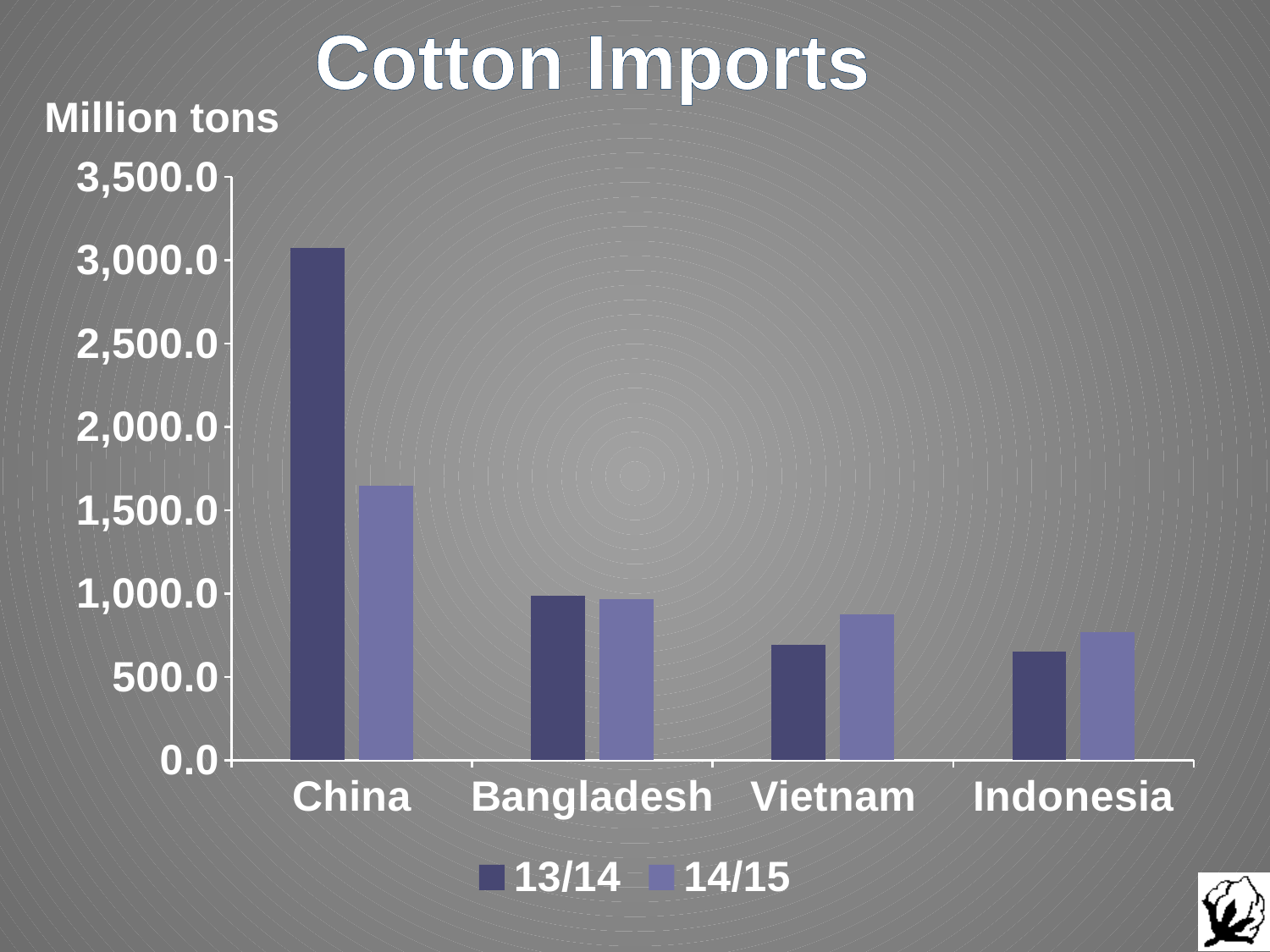
Is the 13/14 value for Indonesia greater or less than 500.0? greater Is the 14/15 value for Vietnam greater or less than 1,000.0? less For Vietnam, which series is larger, 13/14 or 14/15? 14/15 What type of chart is shown on the slide? bar chart For China, which series is larger, 13/14 or 14/15? 13/14 Which country has the highest 13/14 cotton imports? China What unit is given for the y axis of the chart? Million tons How many countries are shown on the x axis? 4 Is the 14/15 value for China greater or less than 1,500.0? greater How many series does the legend list? 2 Which country has the lowest 14/15 cotton imports? Indonesia